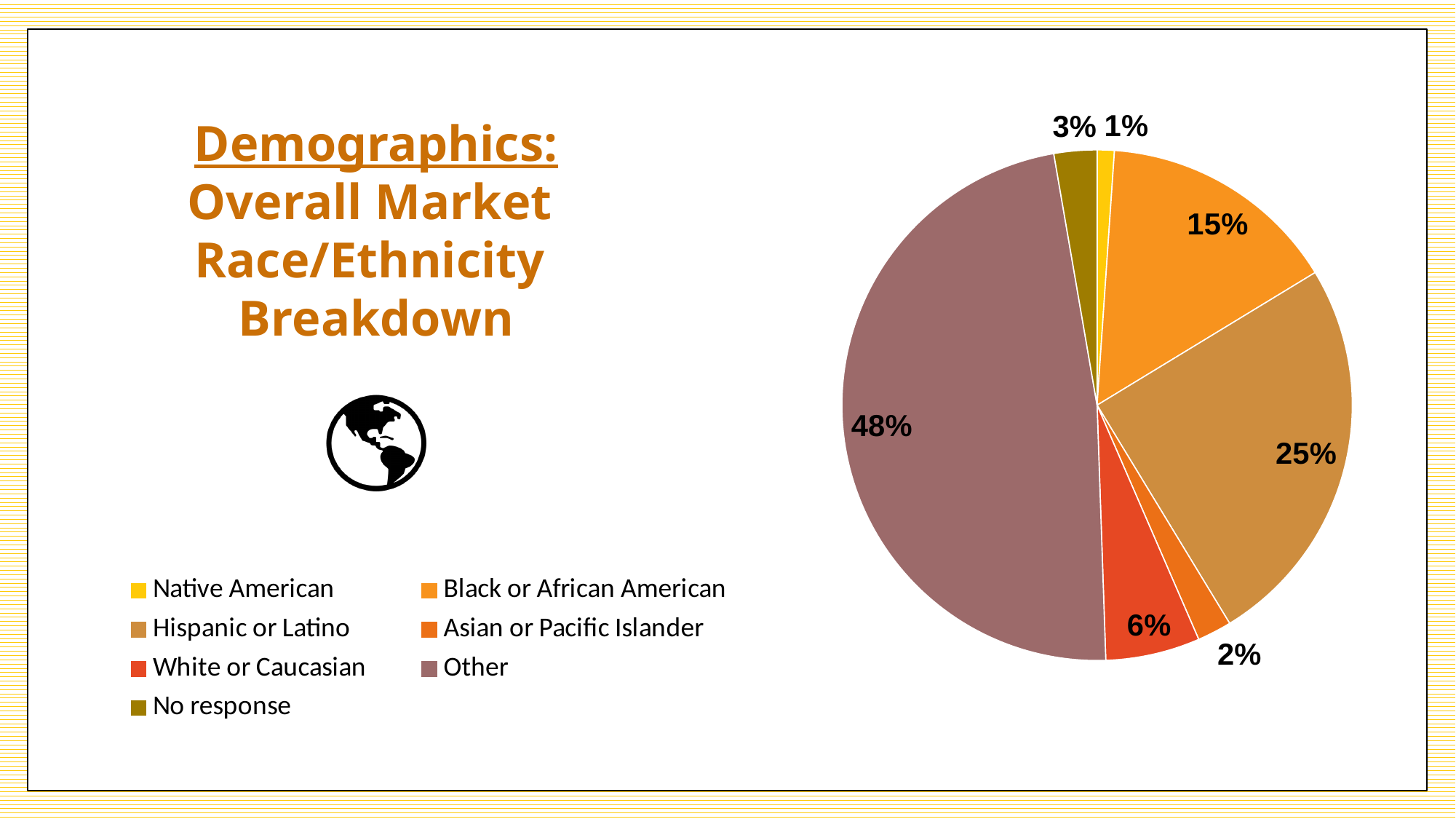
What is the difference between the Hispanic or Latino and Black or African American shares? 10% What is the value for Hispanic or Latino? 25% What is the value for Black or African American? 15% What kind of chart is shown on the slide? pie chart What is the value for White or Caucasian? 6% Which is larger, the share for White or Caucasian or the share for Asian or Pacific Islander? White or Caucasian How many categories does the pie chart have? 7 Which category has the smallest slice of the pie? Native American What is the value for No response? 3% Which category has the largest slice of the pie? Other What is the title of the chart on the slide? Demographics: Overall Market Race/Ethnicity Breakdown What share of the pie does Other represent? 48%